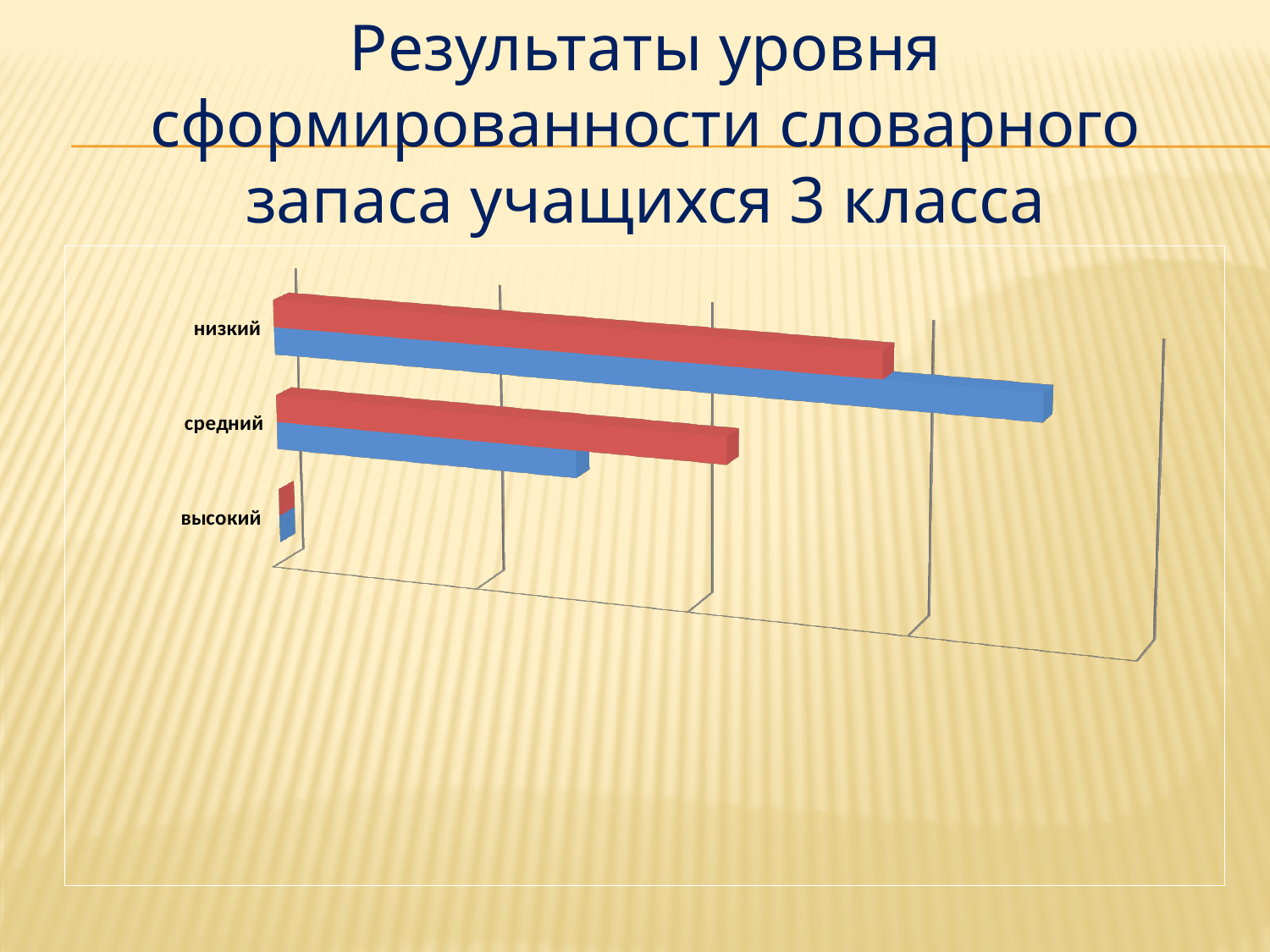
For the category средний, which bar is longer, the red one or the blue one? the red one How many categories are shown on the chart's vertical axis? 3 What kind of chart is shown on the slide? bar chart Which category has the longer red bar, низкий or средний? низкий Are the bars on the chart drawn horizontally or vertically? horizontally Which category has the shortest bars on the chart? высокий What are the category labels on the chart, listed from top to bottom? низкий, средний, высокий For the category низкий, which bar is longer, the red one or the blue one? the blue one Which category has the longest bars on the chart? низкий What two colours are used for the bars on the chart? red and blue